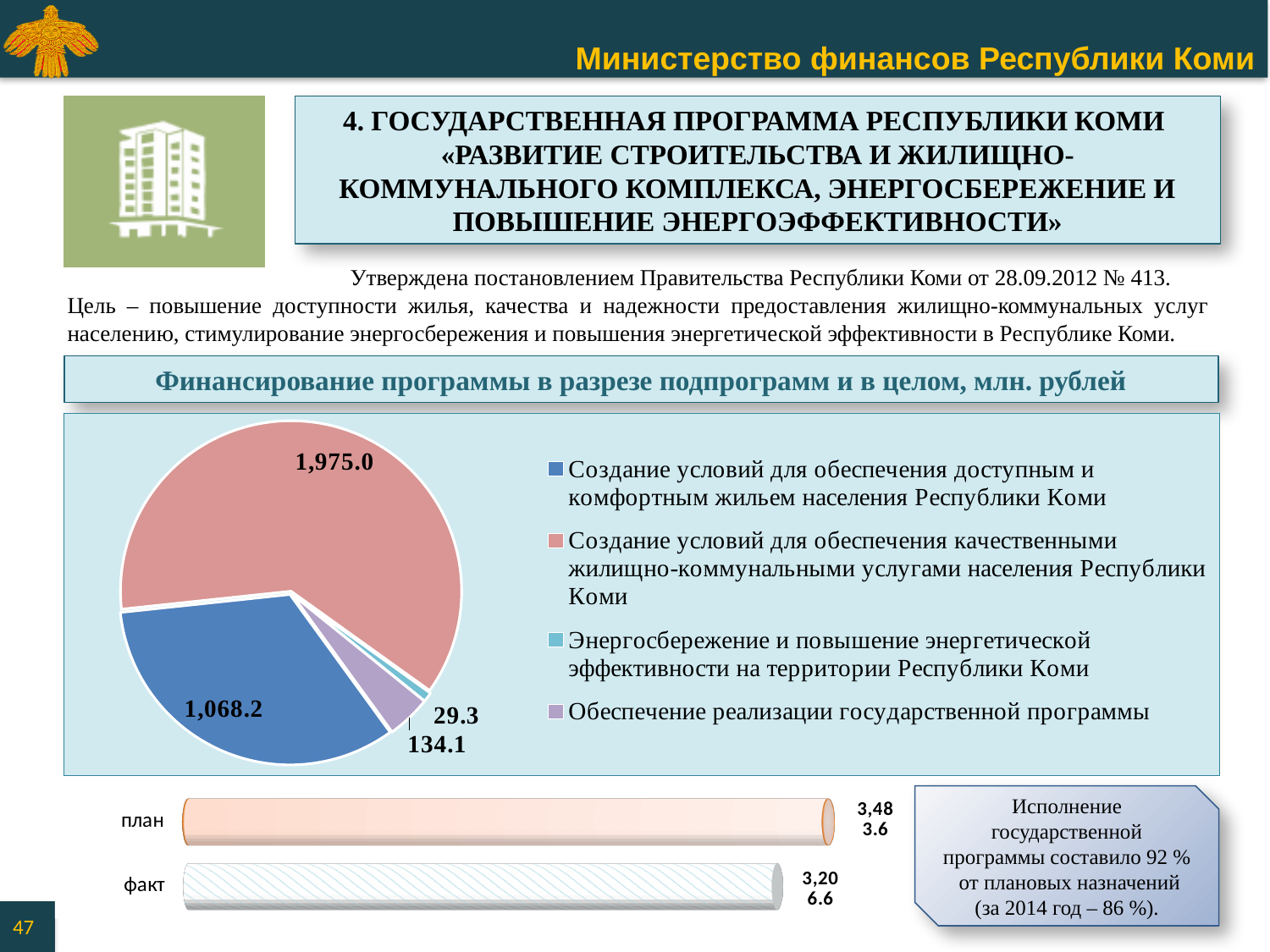
On the pie chart, which subprogram has the smallest slice? Энергосбережение и повышение энергетической эффективности на территории Республики Коми What kind of chart is the upper chart on the slide? pie chart On the pie chart, what is the value for «Создание условий для обеспечения качественными жилищно-коммунальными услугами населения Республики Коми»? 1,975.0 On the pie chart, which subprogram has the largest slice? Создание условий для обеспечения качественными жилищно-коммунальными услугами населения Республики Коми On the pie chart, what is the value for «Создание условий для обеспечения доступным и комфортным жильем населения Республики Коми»? 1,068.2 How many entries does the legend of the pie chart list? 4 On the pie chart, what is the value for «Энергосбережение и повышение энергетической эффективности на территории Республики Коми»? 29.3 On the pie chart, what is the value for «Обеспечение реализации государственной программы»? 134.1 What kind of chart is the lower chart with «план» and «факт»? bar chart On the lower bar chart, which bar is longer, «план» or «факт»? план On the pie chart, what is the difference between the two largest slices, 1,975.0 and 1,068.2? 906.8 On the pie chart, what is the total of all four slices? 3,206.6